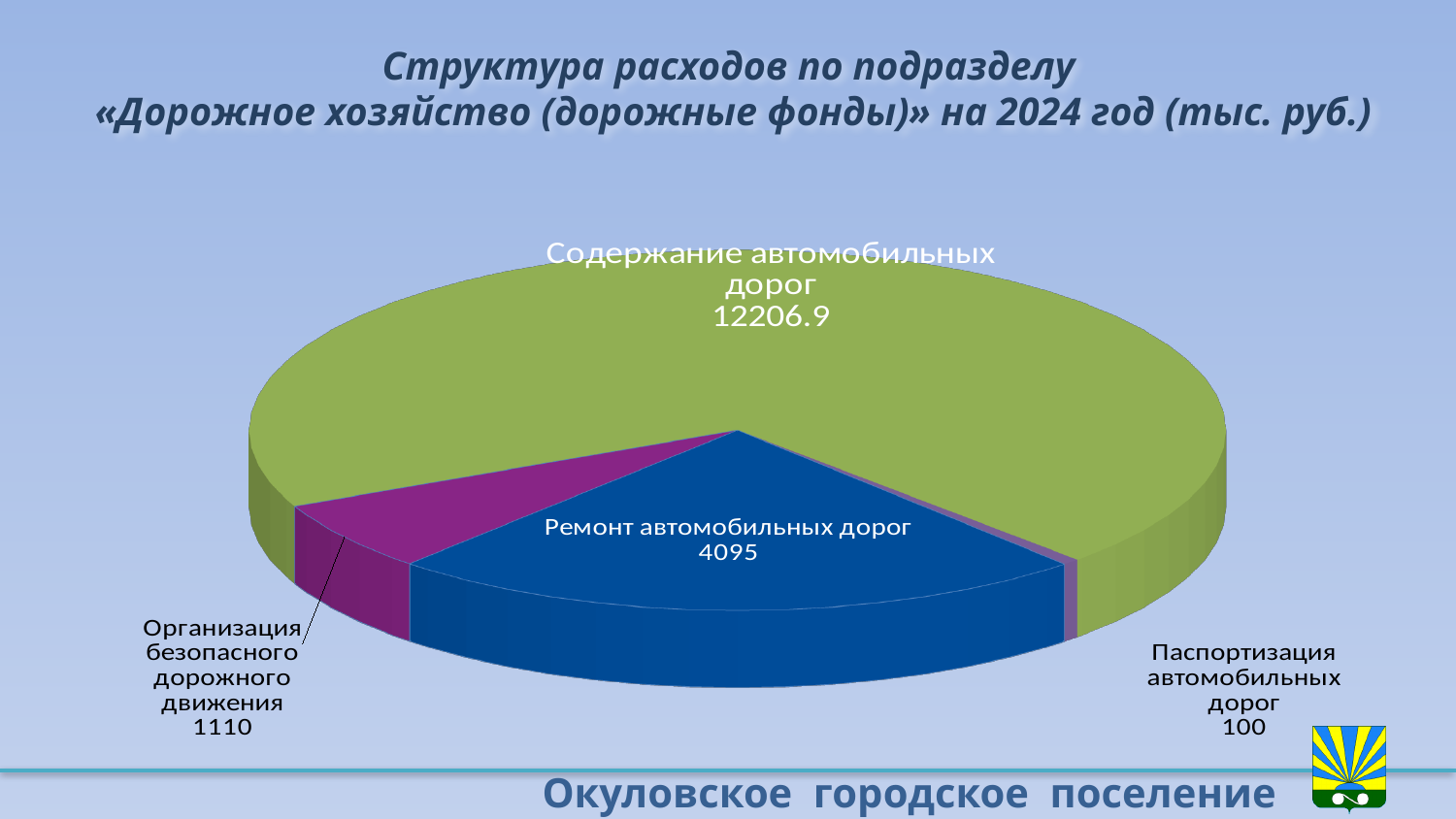
What colour is the slice for «Ремонт автомобильных дорог»? Blue What is the difference between «Ремонт автомобильных дорог» and «Организация безопасного дорожного движения»? 2985 What is the value for «Паспортизация автомобильных дорог»? 100 What is the value for «Содержание автомобильных дорог»? 12206.9 What kind of chart is shown on the slide? Pie chart How many slices does the pie chart have? 4 Which is larger: «Организация безопасного дорожного движения» or «Паспортизация автомобильных дорог»? Организация безопасного дорожного движения What is the value for «Ремонт автомобильных дорог»? 4095 Which category has the largest slice of the pie? Содержание автомобильных дорог What is the value for «Организация безопасного дорожного движения»? 1110 Which category has the smallest slice of the pie? Паспортизация автомобильных дорог What is the difference between «Содержание автомобильных дорог» and «Ремонт автомобильных дорог»? 8111.9